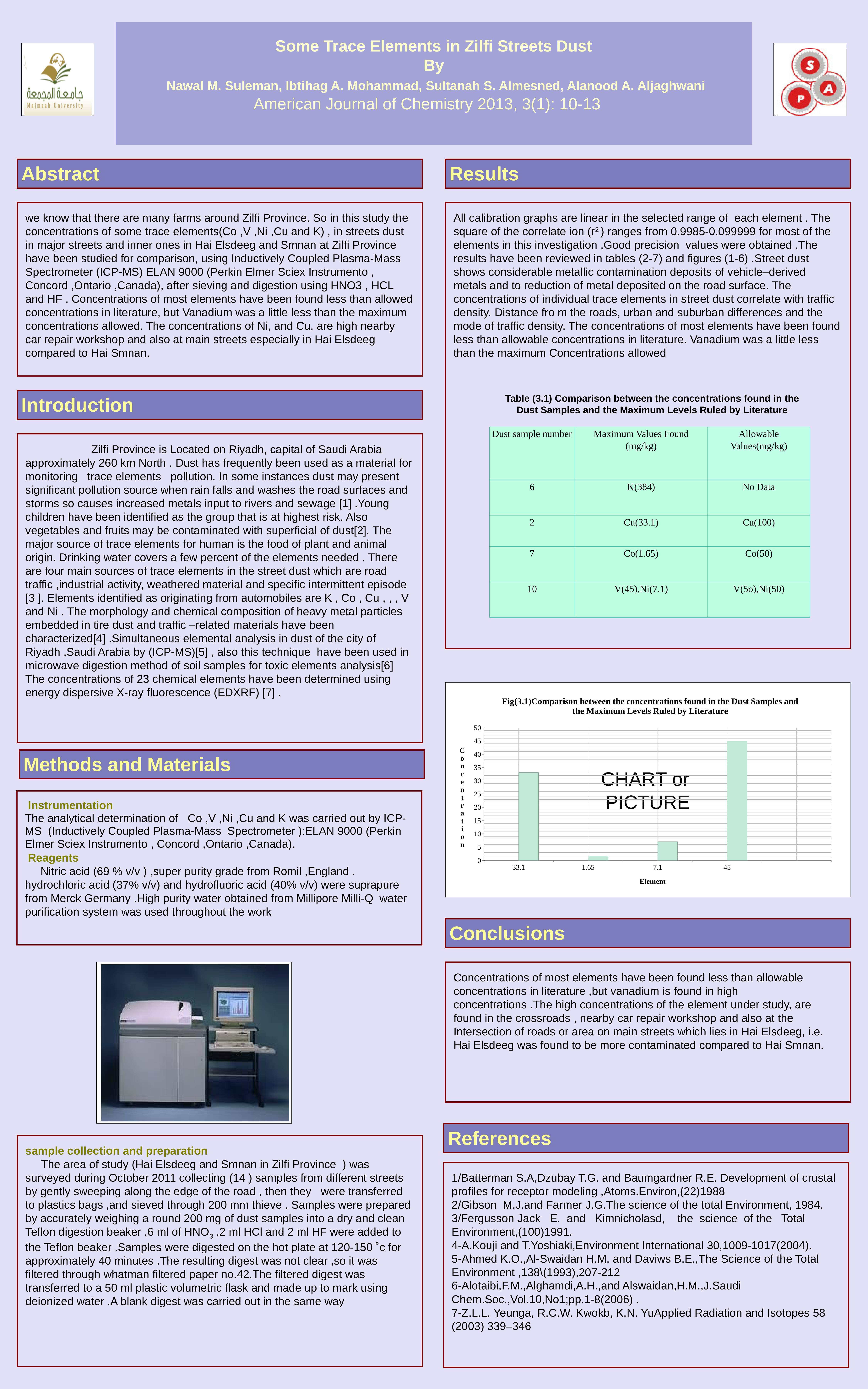
In the Fig(3.1) chart, which bar is taller: the one for category 1.65 or the one for category 7.1? 7.1 What kind of chart is Fig(3.1)? bar chart What is the x-axis title of the Fig(3.1) chart? Element In the Fig(3.1) chart, which category has the tallest bar? 45 In the Fig(3.1) chart, is the bar for category 45 greater or less than 40? greater In the Fig(3.1) chart, is the bar for category 1.65 greater or less than 5? less In the Fig(3.1) chart, which bar is taller: the one for category 33.1 or the one for category 7.1? 33.1 In the Fig(3.1) chart, which category has the shortest bar? 1.65 How many bars are plotted in the Fig(3.1) chart? 4 In the Fig(3.1) chart, is the bar for category 33.1 greater or less than 35? less